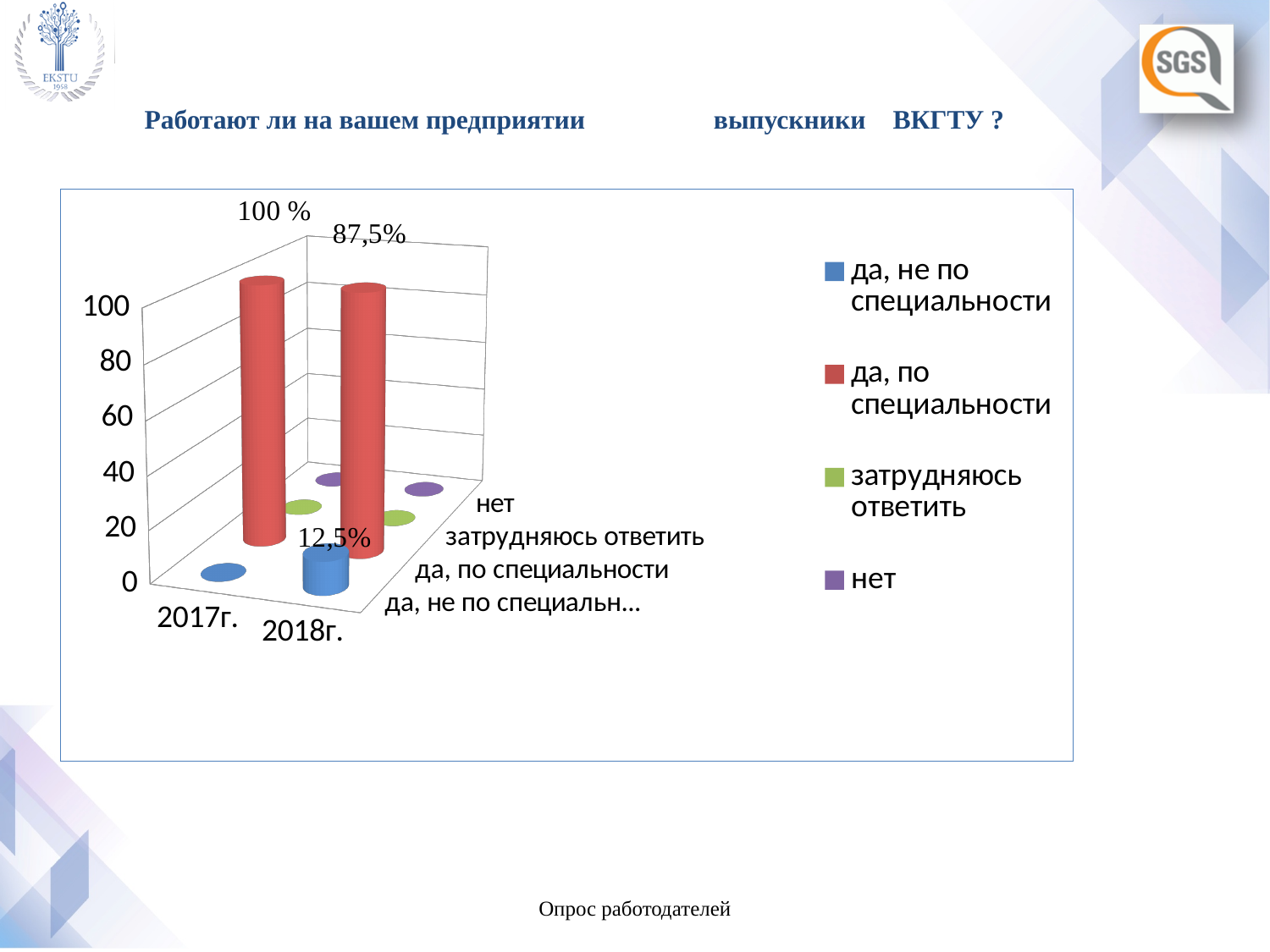
What is the value for "да, по специальности" in 2017г.? 100 % What is the difference between the "да, по специальности" values for 2017г. and 2018г.? 12,5% How many year categories are shown on the x axis of the chart? 2 What kind of chart is shown on the slide? bar chart What is the value for "да, по специальности" in 2018г.? 87,5% Is the value for "да, не по специальности" in 2018г. greater or less than 20? less What is the value for "да, не по специальности" in 2018г.? 12,5% How many series does the chart legend list? 4 Does the value for "да, по специальности" rise or fall from 2017г. to 2018г.? fall Which year has the higher value for "да, по специальности", 2017г. or 2018г.? 2017г. What colour represents the series "нет" in the chart legend? purple Which series has the highest value in 2018г.? да, по специальности